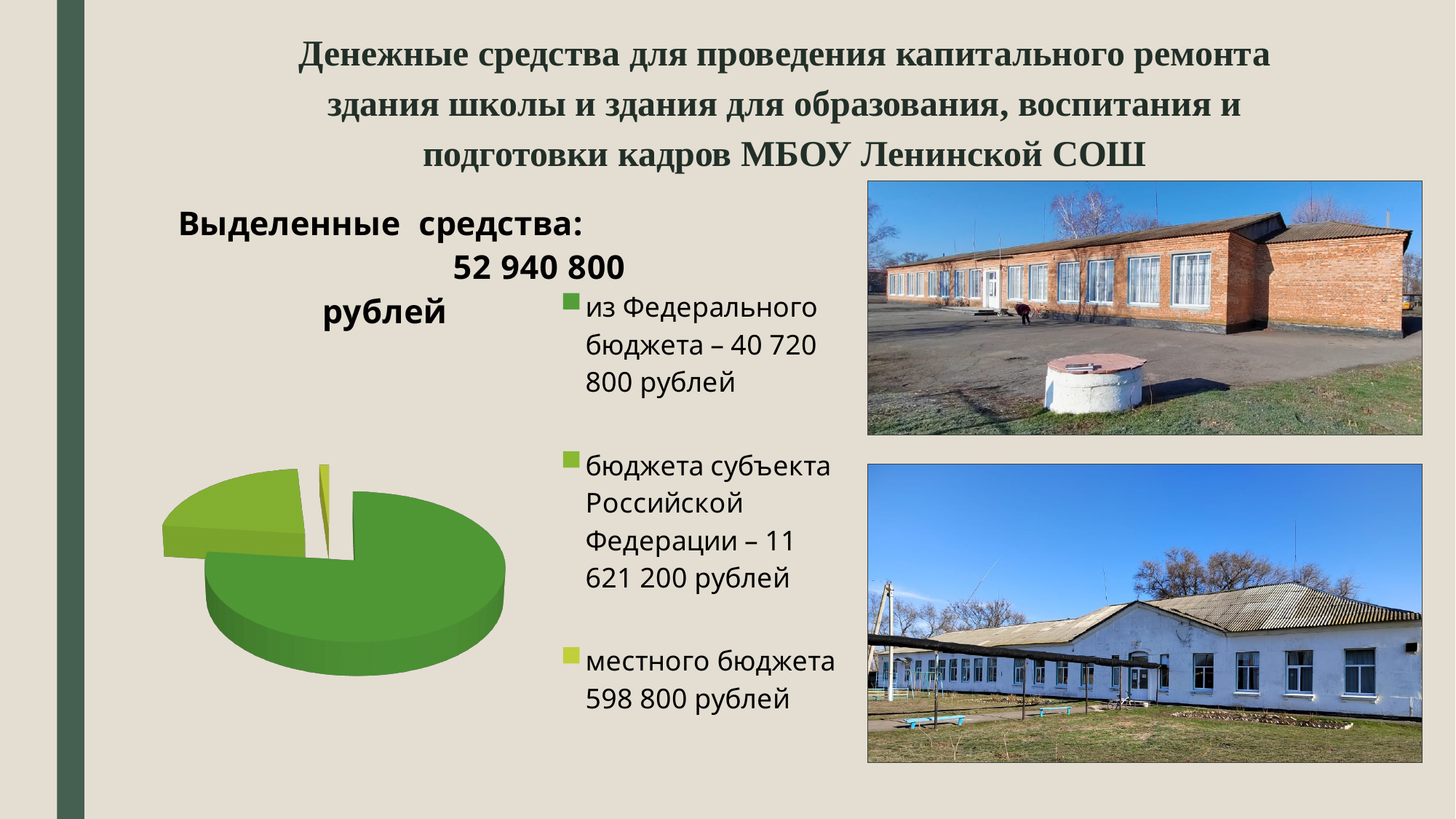
How many slices does the pie chart have? 3 What colour is the slice representing the Federal budget in the pie chart? dark green What is the difference between the Federal budget contribution and the contribution from the budget of the subject of the Russian Federation? 29 099 600 рублей How much money came from the budget of the subject of the Russian Federation (бюджета субъекта Российской Федерации)? 11 621 200 рублей How many funding sources are listed in the legend next to the pie chart? 3 What kind of chart is shown on the slide? pie chart Which funding source is the largest slice of the pie chart? из Федерального бюджета Which funding source is the smallest slice of the pie chart? местного бюджета How much money came from the Federal budget (из Федерального бюджета)? 40 720 800 рублей Which is larger: the contribution from the budget of the subject of the Russian Federation or from the local budget? бюджета субъекта Российской Федерации How much money came from the local budget (местного бюджета)? 598 800 рублей What is the total amount of allocated funds (Выделенные средства) shown on the slide? 52 940 800 рублей